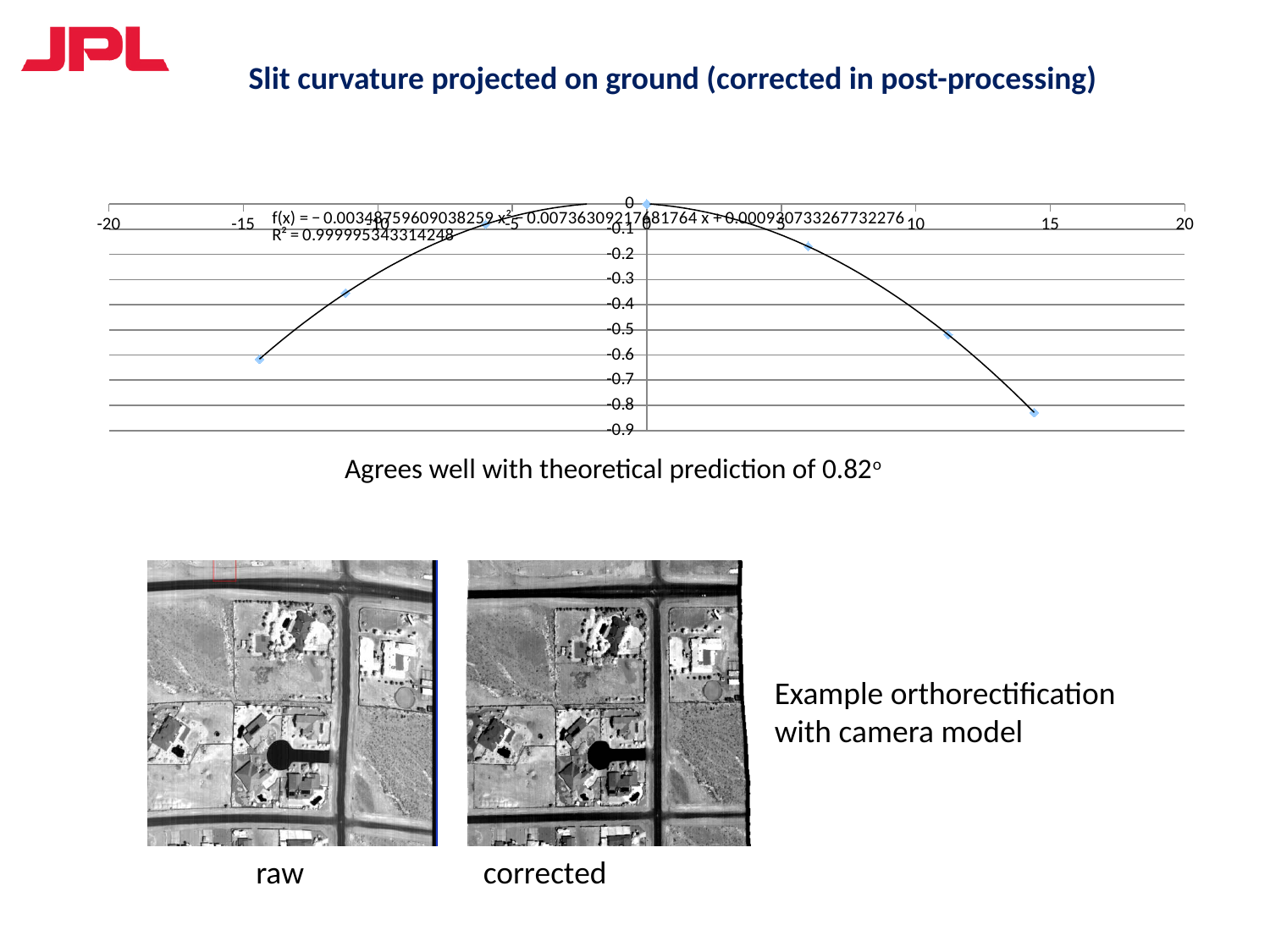
At which x value does the plotted curve reach its highest point? 0 What is the lowest value shown on the chart's y axis? -0.9 Do the plotted values rise or fall as x increases from 0 to 15? fall Is the y value of the rightmost data point (near x = 14) greater or less than -0.7? less Is the y value of the leftmost data point (near x = -14) greater or less than -0.5? less Is the y value of the data point near x = 6 greater or less than -0.3? greater What kind of chart is shown on the slide? scatter chart with a fitted curve How many data points are plotted on the chart? 7 What is the R² value printed on the chart? 0.999995343314248 What is the highest value shown on the chart's y axis? 0 Do the plotted values rise or fall as x increases from -15 to 0? rise Which data point has the lower y value: the leftmost point (near x = -14) or the rightmost point (near x = 14)? the rightmost point